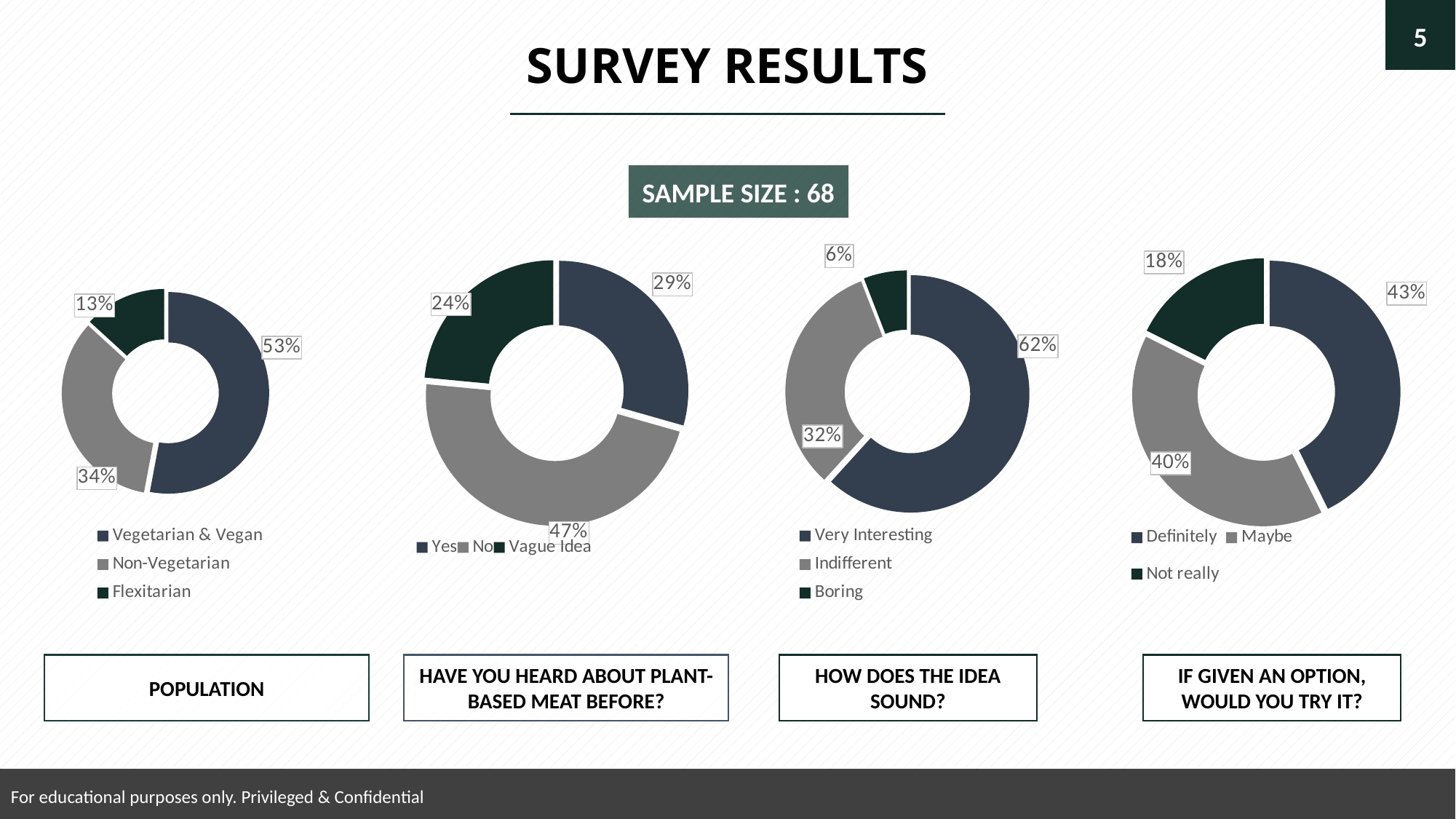
What kind of chart is the POPULATION chart? Doughnut (pie) chart In the POPULATION chart, which category has the smallest share? Flexitarian In the 'IF GIVEN AN OPTION, WOULD YOU TRY IT?' chart, what share answered Not really? 18% In the POPULATION chart, which category has the largest share? Vegetarian & Vegan In the 'HOW DOES THE IDEA SOUND?' chart, what share answered Boring? 6% How many categories does the legend of the 'IF GIVEN AN OPTION, WOULD YOU TRY IT?' chart list? 3 In the 'IF GIVEN AN OPTION, WOULD YOU TRY IT?' chart, which is larger, Definitely or Maybe? Definitely In the 'HAVE YOU HEARD ABOUT PLANT-BASED MEAT BEFORE?' chart, what is the difference between the Yes and Vague Idea shares? 5% In the POPULATION chart, what share of respondents are Non-Vegetarian? 34% In the 'HOW DOES THE IDEA SOUND?' chart, which response has the largest share? Very Interesting In the 'HAVE YOU HEARD ABOUT PLANT-BASED MEAT BEFORE?' chart, what share answered No? 47% In the 'HOW DOES THE IDEA SOUND?' chart, what is the difference between the Very Interesting and Indifferent shares? 30%